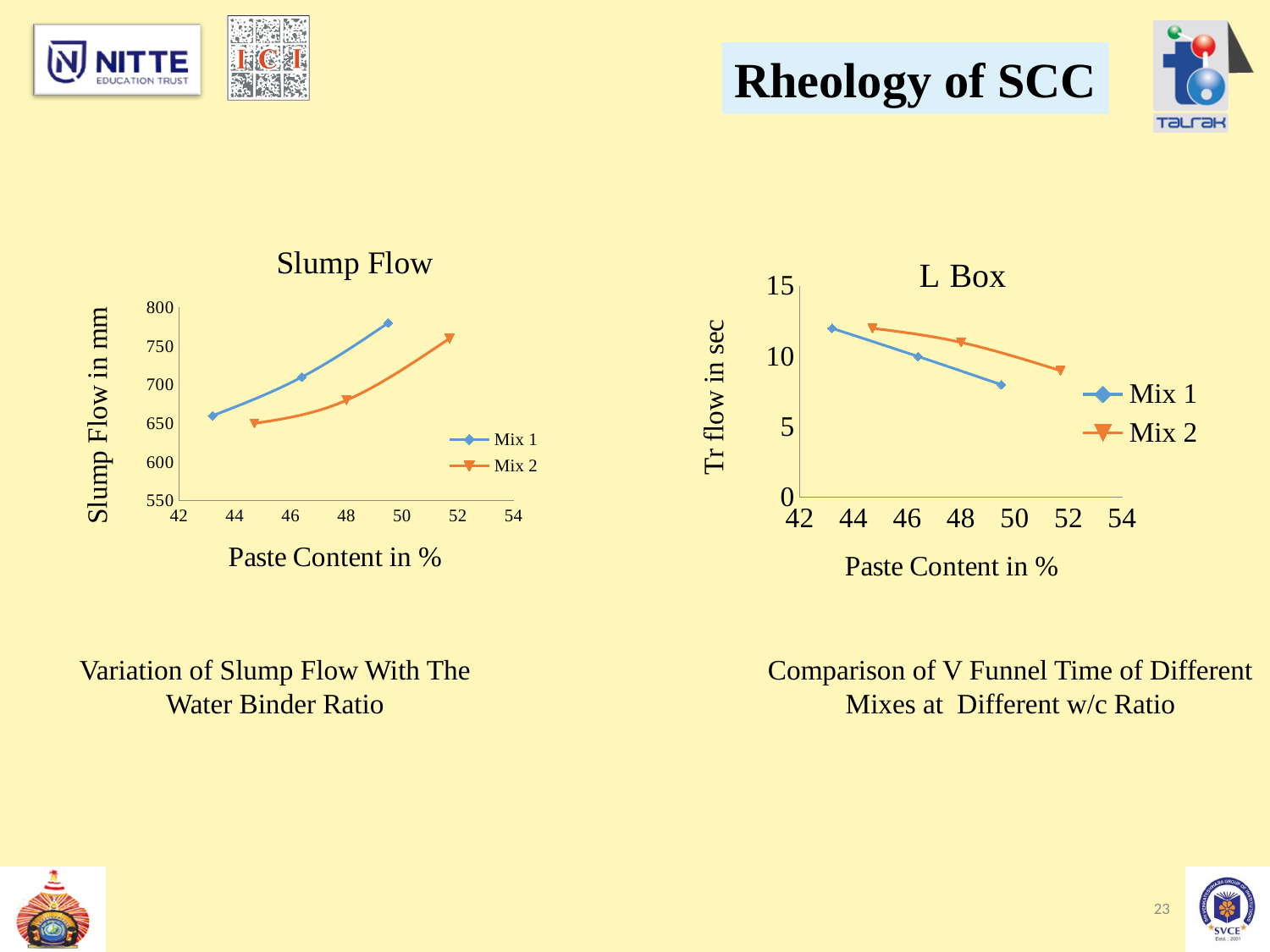
In the Slump Flow chart, do the Mix 1 values rise or fall as paste content increases? rise How many series does the legend of the L Box chart list? 2 In the L Box chart, is the lowest Mix 1 value greater or less than 10? less In the L Box chart, do the Mix 2 values rise or fall as paste content increases? fall What is the y-axis label of the L Box chart? Tr flow in sec In the L Box chart, how many data points are plotted for Mix 2? 3 How many series does the legend of the Slump Flow chart list? 2 In the Slump Flow chart, which series has the higher slump flow at its last plotted point, Mix 1 or Mix 2? Mix 1 What type of chart is the L Box chart? line chart In the Slump Flow chart, how many data points are plotted for Mix 1? 3 What type of chart is the Slump Flow chart? line chart In the Slump Flow chart, is the highest Mix 1 value greater or less than 750? greater